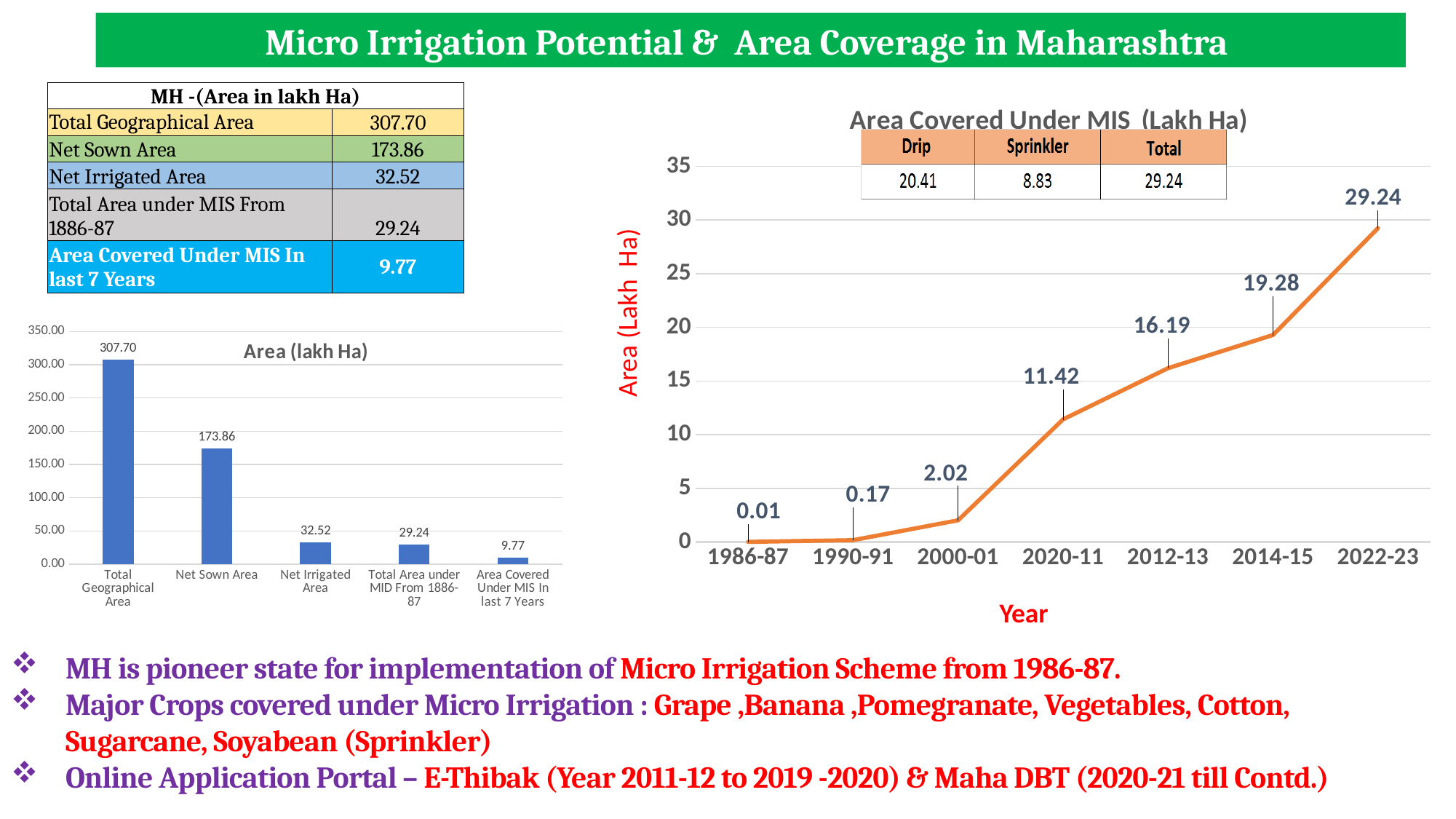
In the line chart titled "Area Covered Under MIS (Lakh Ha)", which year has the highest value? 2022-23 In the line chart titled "Area Covered Under MIS (Lakh Ha)", how many data points are plotted? 7 In the bar chart titled "Area (lakh Ha)", what is the value for Net Sown Area? 173.86 In the bar chart titled "Area (lakh Ha)", which category has the highest value? Total Geographical Area In the line chart titled "Area Covered Under MIS (Lakh Ha)", what is the value for 2000-01? 2.02 In the line chart titled "Area Covered Under MIS (Lakh Ha)", what is the difference between the values for 2022-23 and 2014-15? 9.96 In the line chart titled "Area Covered Under MIS (Lakh Ha)", do the values rise or fall from 1986-87 to 2022-23? Rise What kind of chart is the one titled "Area (lakh Ha)" on the left of the slide? Bar chart In the bar chart titled "Area (lakh Ha)", which category has the lowest value? Area Covered Under MIS In last 7 Years In the bar chart titled "Area (lakh Ha)", what is the difference between Total Geographical Area and Net Sown Area? 133.84 In the line chart titled "Area Covered Under MIS (Lakh Ha)", what is the value for 2012-13? 16.19 In the bar chart titled "Area (lakh Ha)", how many categories are shown? 5